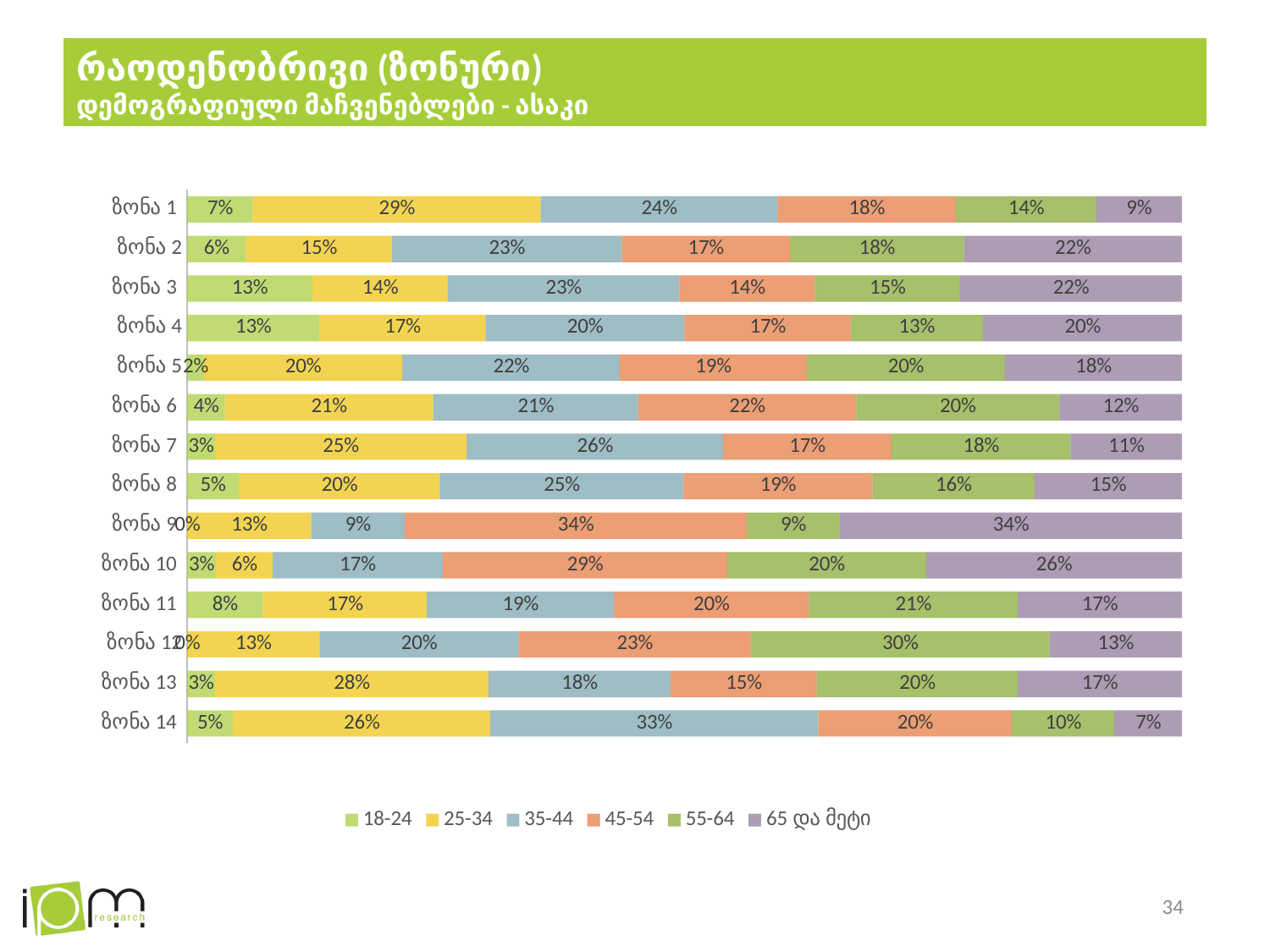
Which is larger: the 65 და მეტი value for ზონა 2 or for ზონა 6? ზონა 2 What kind of chart is shown on the slide? stacked bar chart How many zones (categories) are shown in the chart? 14 What is the value for the 35-44 series in ზონა 14? 33% What is the difference between the 45-54 values for ზონა 9 and ზონა 1? 16% Which zone has the lowest value for the 25-34 series? ზონა 10 Which zone has the highest value for the 35-44 series? ზონა 14 What is the value for the 25-34 series in ზონა 1? 29% What is the last series listed in the legend? 65 და მეტი What is the value for the 55-64 series in ზონა 12? 30% What is the value for the 45-54 series in ზონა 9? 34% How many series does the legend list? 6